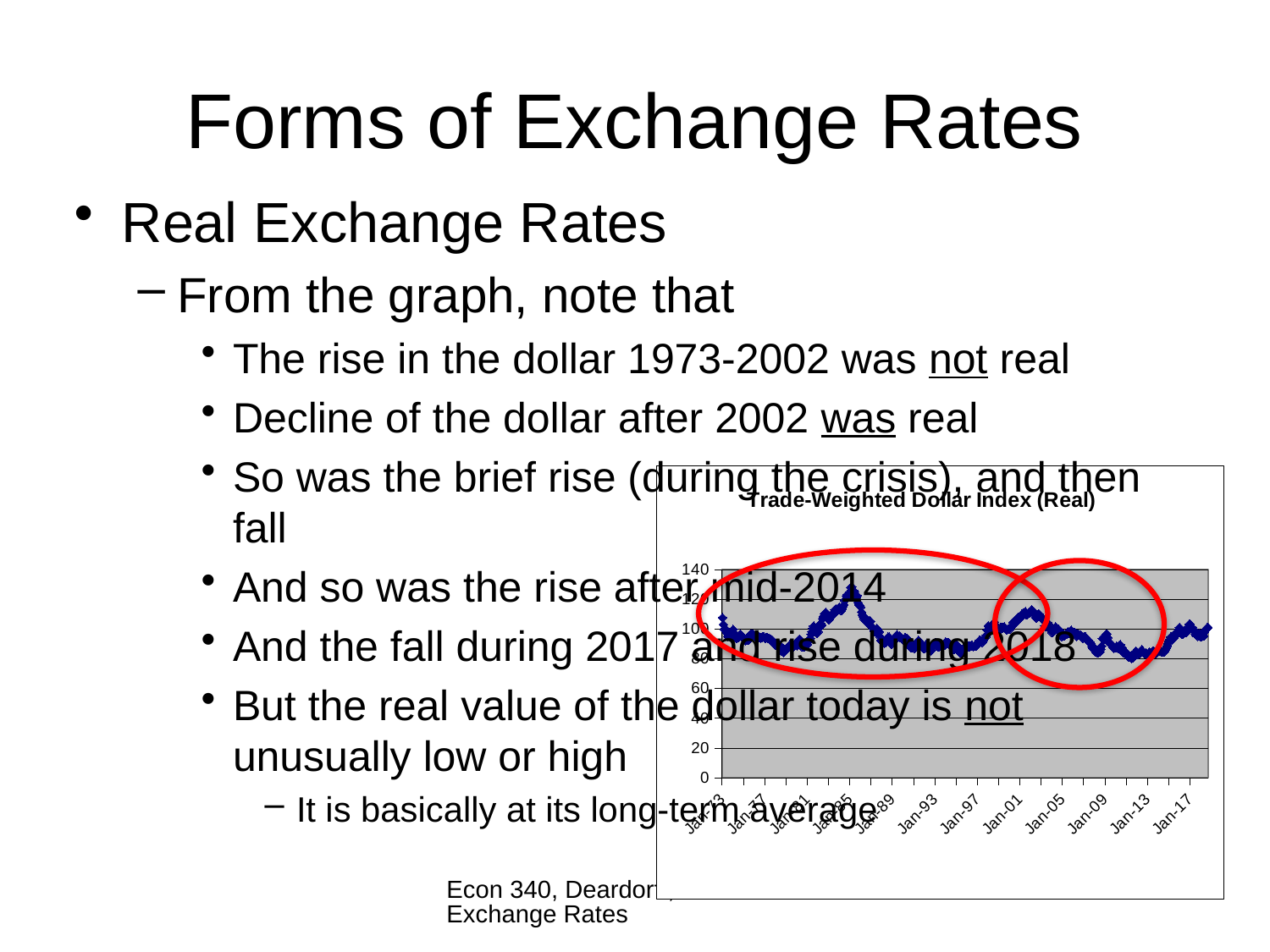
Around which x-axis label does the Trade-Weighted Dollar Index reach its highest value? Jan-85 Which is larger, the index value around Jan-85 or the index value around Jan-13? Jan-85 Is the value of the index around Jan-09 greater or less than 120? less What is the highest value shown on the chart's vertical axis? 140 What kind of chart is shown on the slide? line chart Is the value of the index at Jan-73 greater or less than 60? greater Is the value of the index around Jan-85 greater or less than 100? greater Does the index rise or fall between Jan-81 and Jan-85? rise How many date labels are shown along the x axis of the chart? 12 What is the title of the chart on the slide? Trade-Weighted Dollar Index (Real) Does the index rise or fall between Jan-85 and Jan-89? fall